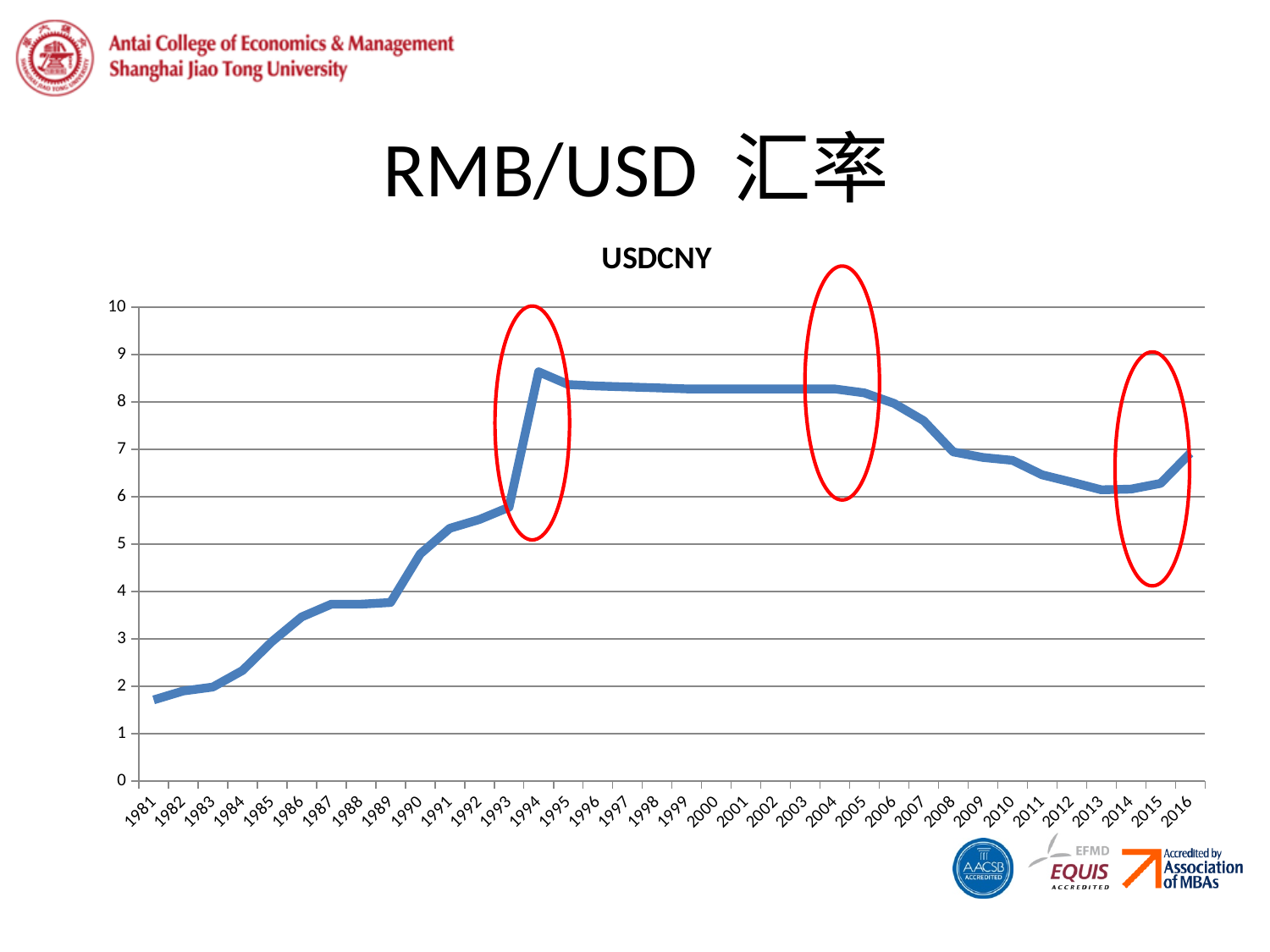
Is the value for 1994 greater or less than 8? greater Is the value for 1981 greater or less than 2? less Which year has the larger USDCNY value, 1993 or 1994? 1994 How many years are shown on the x axis of the chart? 36 What is the title of the chart? USDCNY Does the USDCNY value rise or fall from 1981 to 1994? rise Does the USDCNY value rise or fall from 2005 to 2013? fall What kind of chart is shown on the slide? line chart Is the value for 1989 greater or less than 4? less In which year does the USDCNY line reach its highest value? 1994 In which year is the USDCNY value lowest? 1981